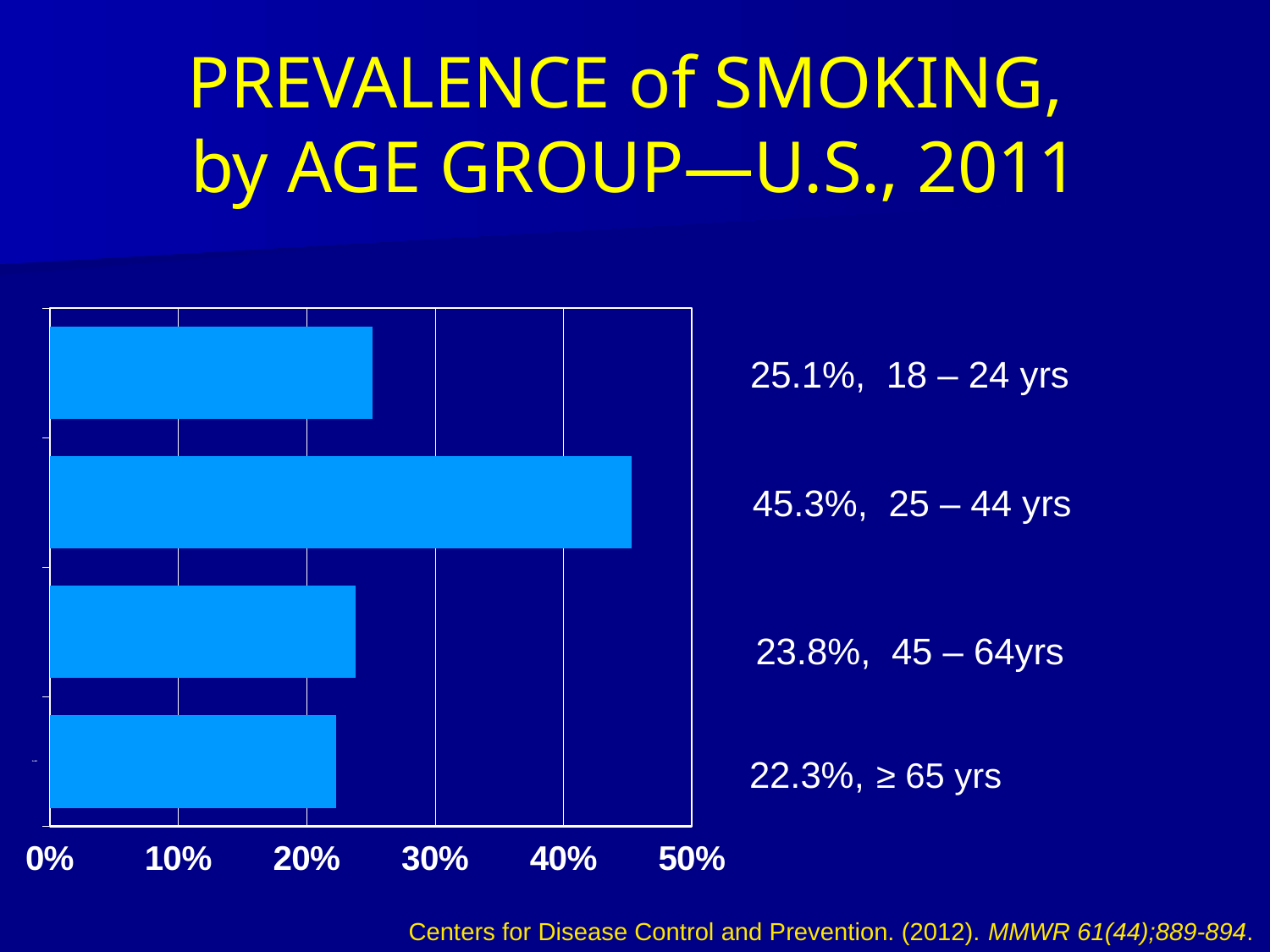
Which age group has the lowest smoking prevalence? ≥ 65 yrs How many age groups are shown in the chart? 4 What is the difference in smoking prevalence between the 45 – 64 yrs group and the ≥ 65 yrs group? 1.5% What is the smoking prevalence for the 25 – 44 yrs age group? 45.3% What is the smoking prevalence for the ≥ 65 yrs age group? 22.3% Is the smoking prevalence for the 25 – 44 yrs group greater or less than 40%? greater Which age group has the highest smoking prevalence? 25 – 44 yrs Which has a higher smoking prevalence, the 18 – 24 yrs group or the 45 – 64 yrs group? 18 – 24 yrs What is the difference in smoking prevalence between the 25 – 44 yrs group and the 18 – 24 yrs group? 20.2% What is the maximum value shown on the percentage axis of the chart? 50% What is the smoking prevalence for the 18 – 24 yrs age group? 25.1% What type of chart is shown on the slide? Bar chart